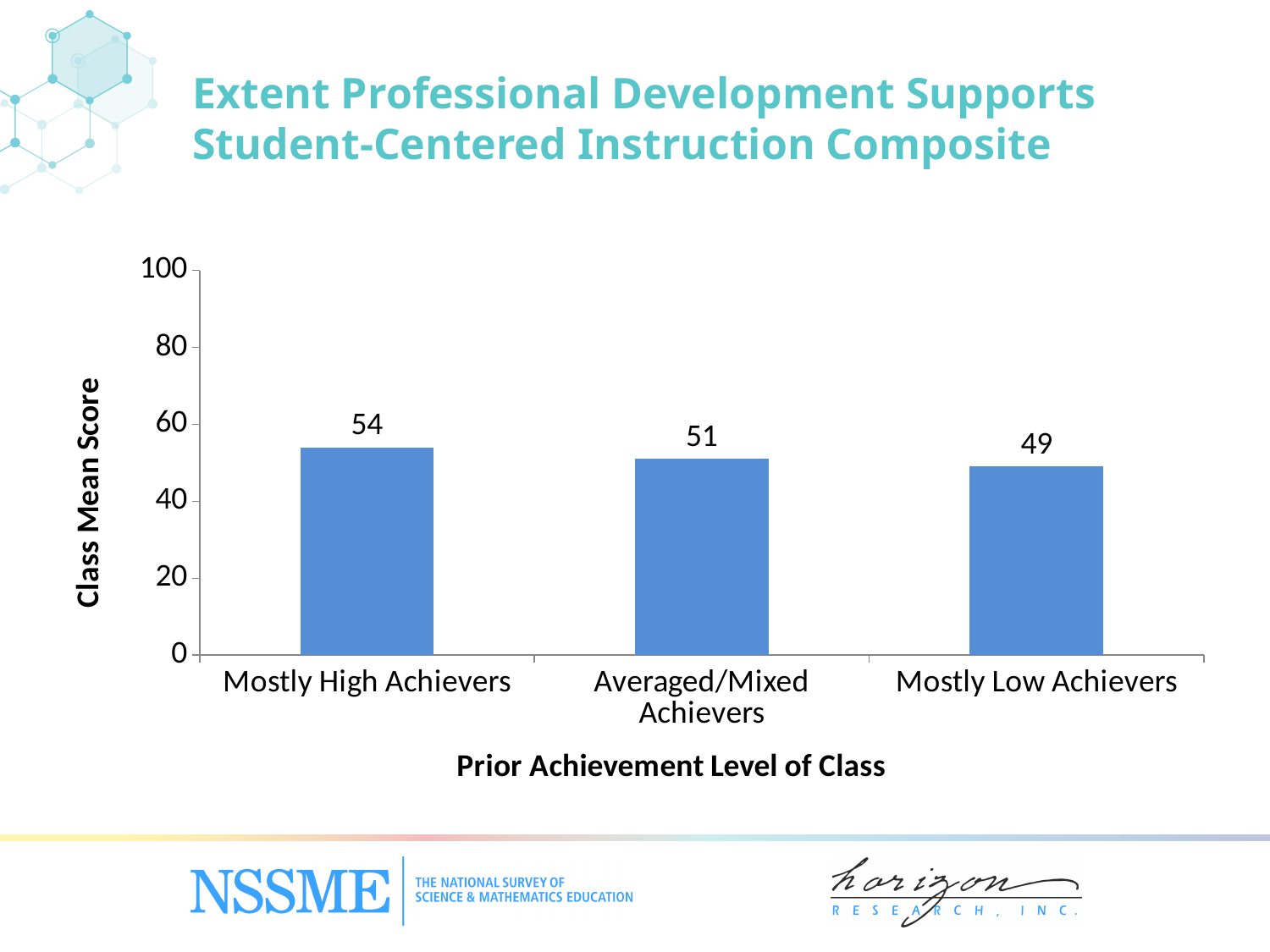
Do the class mean scores rise or fall moving from Mostly High Achievers to Mostly Low Achievers? fall What is the class mean score for Mostly Low Achievers? 49 What is the difference between the class mean scores for Mostly High Achievers and Mostly Low Achievers? 5 Which prior achievement level has the highest class mean score? Mostly High Achievers Which has a higher class mean score, Mostly High Achievers or Averaged/Mixed Achievers? Mostly High Achievers Which prior achievement level has the lowest class mean score? Mostly Low Achievers What is the class mean score for Averaged/Mixed Achievers? 51 How many prior achievement level categories are shown on the chart? 3 What is the difference between the class mean scores for Averaged/Mixed Achievers and Mostly Low Achievers? 2 Is the value for Mostly Low Achievers greater or less than 60? less What is the class mean score for Mostly High Achievers? 54 What kind of chart is shown on the slide? bar chart